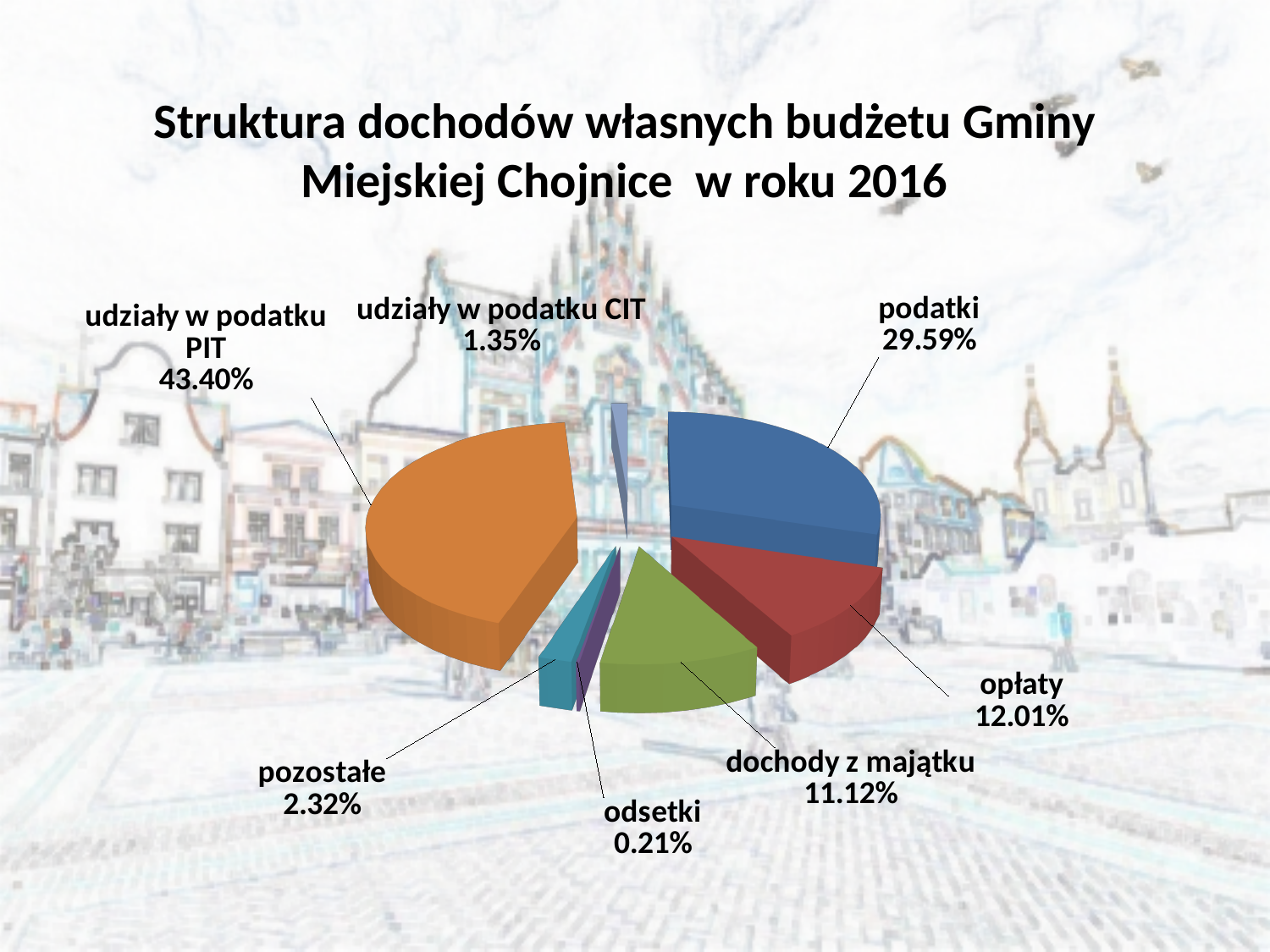
What is the value shown for 'dochody z majątku'? 11.12% How many categories are shown in the pie chart? 7 What share of the pie does 'udziały w podatku PIT' represent? 43.40% What is the difference between the shares of 'podatki' and 'opłaty'? 17.58% What kind of chart is shown on the slide? pie chart What is the value shown for 'opłaty'? 12.01% What is the title of the chart? Struktura dochodów własnych budżetu Gminy Miejskiej Chojnice w roku 2016 Which category has the largest share of the pie? udziały w podatku PIT What is the value shown for 'odsetki'? 0.21% Which category has the smallest share of the pie? odsetki What is the value shown for 'podatki'? 29.59% Which is larger, 'pozostałe' or 'udziały w podatku CIT'? pozostałe